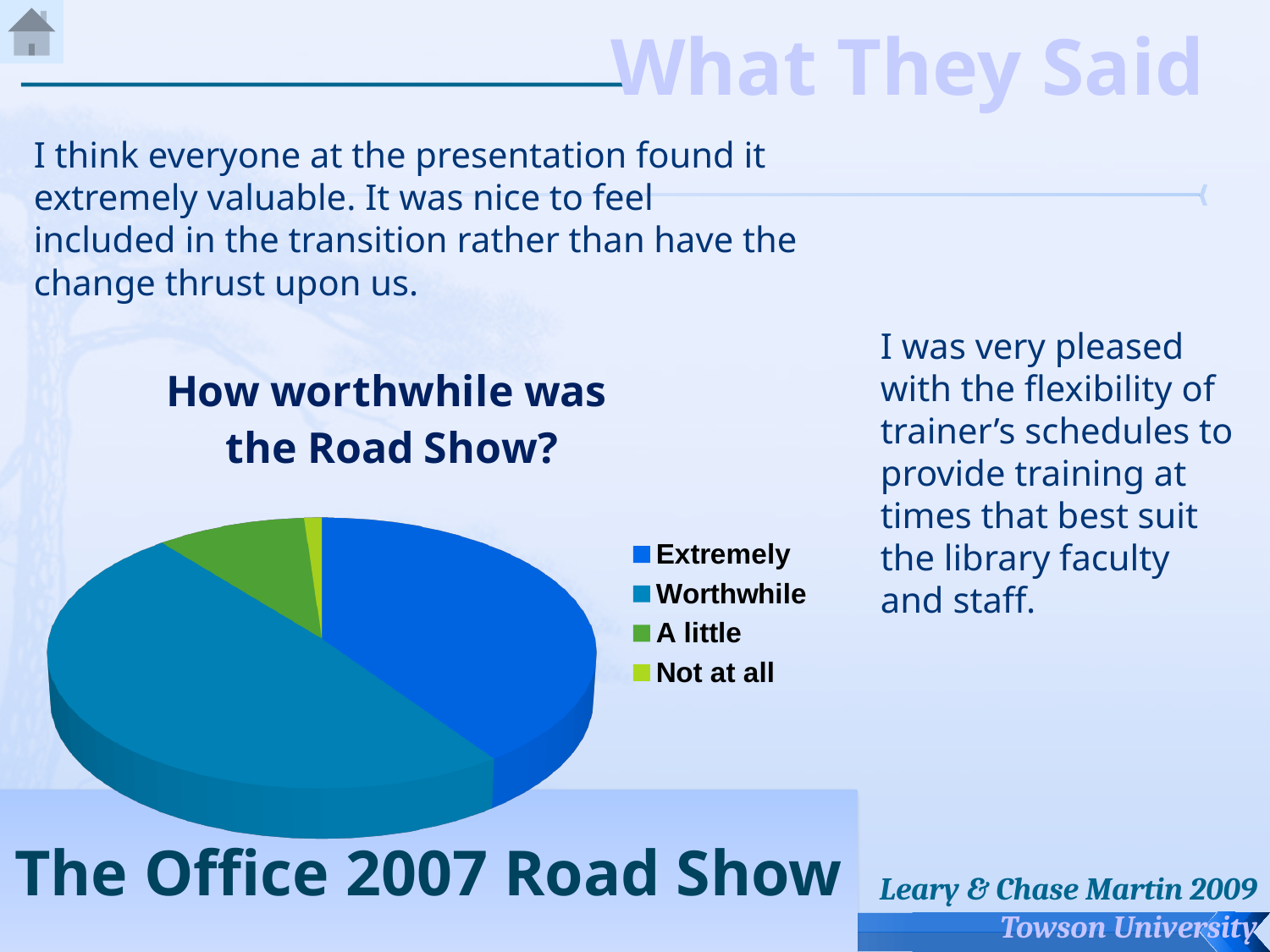
Which category has the smallest slice of the pie? Not at all Which slice is larger, A little or Not at all? A little Which legend entry is listed first in the chart's legend? Extremely What kind of chart is shown on the slide? pie chart Which category has the largest slice of the pie? Worthwhile Which slice is larger, Extremely or A little? Extremely Which category is the second-largest slice of the pie? Extremely What is the title of the chart? How worthwhile was the Road Show? How many categories does the pie chart have? 4